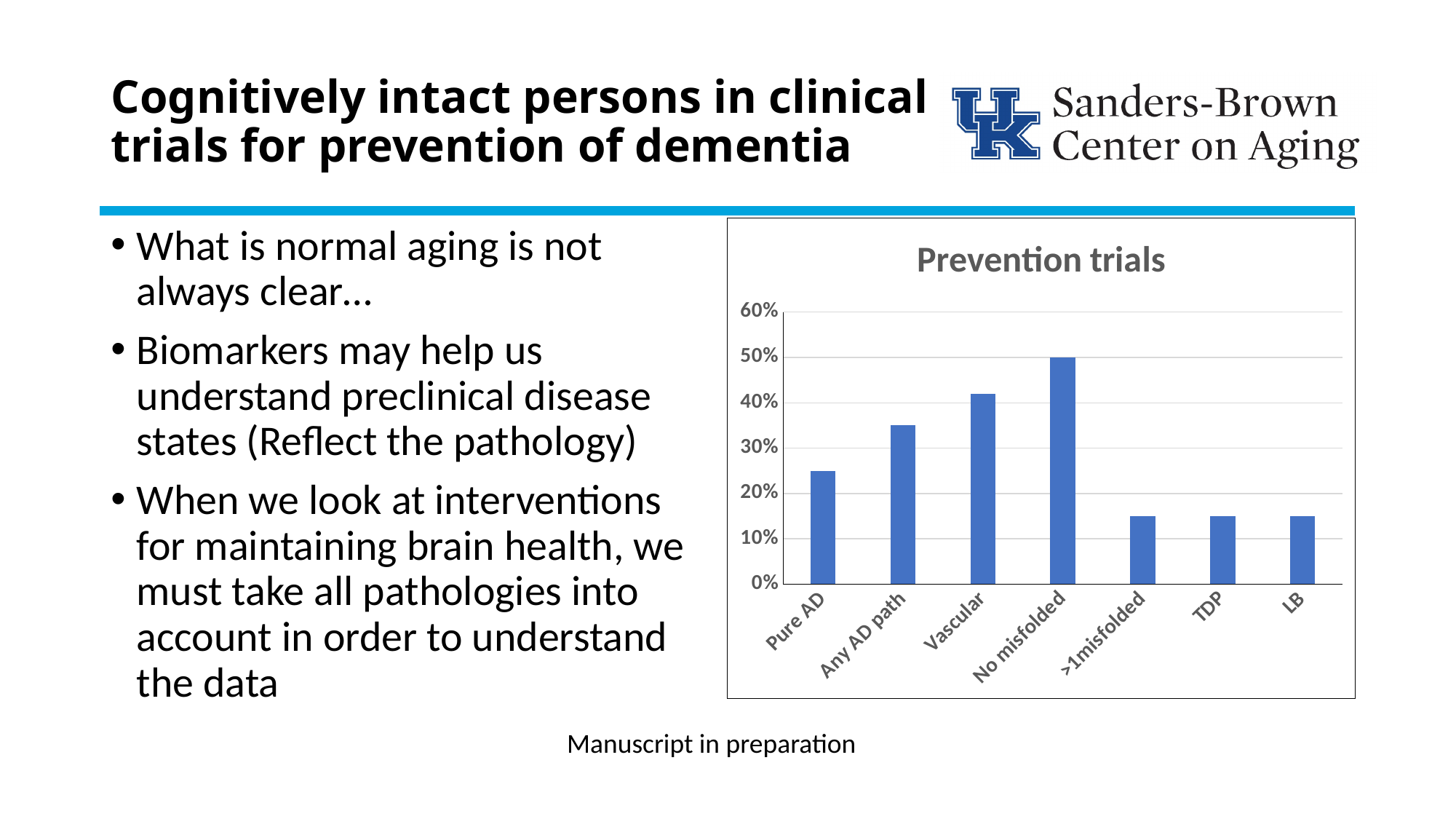
Is the value for TDP greater or less than 20%? less What is the value for No misfolded in the Prevention trials chart? 50% What kind of chart is shown on the slide? bar chart Is the value for Vascular greater or less than 40%? greater Which category has the highest value in the Prevention trials chart? No misfolded Is the value for Any AD path greater or less than 30%? greater What is the highest value shown on the vertical axis of the chart? 60% Which is larger, the value for Vascular or the value for Any AD path? Vascular What is the title of the chart? Prevention trials How many categories are plotted in the Prevention trials chart? 7 Which is larger, the value for Pure AD or the value for LB? Pure AD